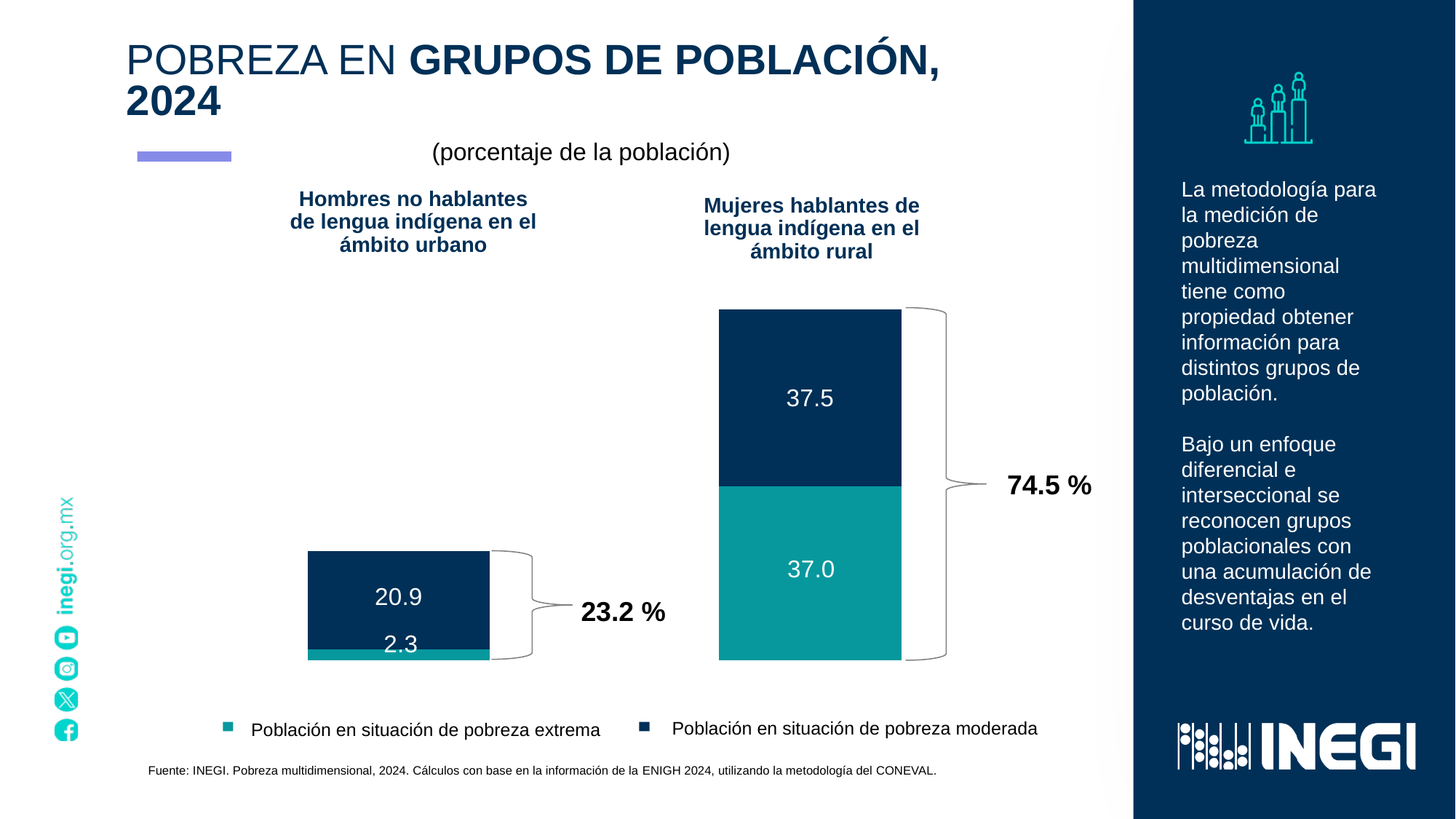
What is the value for 'Población en situación de pobreza extrema' for 'Hombres no hablantes de lengua indígena en el ámbito urbano'? 2.3 Which group has the higher value for 'Población en situación de pobreza moderada'? Mujeres hablantes de lengua indígena en el ámbito rural What is the difference between the 'Población en situación de pobreza moderada' values of the two groups? 16.6 What is the difference between the total values of the two bars? 51.3 What is the value for 'Población en situación de pobreza extrema' for 'Mujeres hablantes de lengua indígena en el ámbito rural'? 37.0 How many series does the legend list? 2 What kind of chart is shown on the slide? Stacked bar chart What is the value for 'Población en situación de pobreza moderada' for 'Mujeres hablantes de lengua indígena en el ámbito rural'? 37.5 Which group has the lower value for 'Población en situación de pobreza extrema'? Hombres no hablantes de lengua indígena en el ámbito urbano What is the total shown for the 'Hombres no hablantes de lengua indígena en el ámbito urbano' bar? 23.2 % How many groups (bars) are shown in the chart? 2 What is the total shown for the 'Mujeres hablantes de lengua indígena en el ámbito rural' bar? 74.5 %